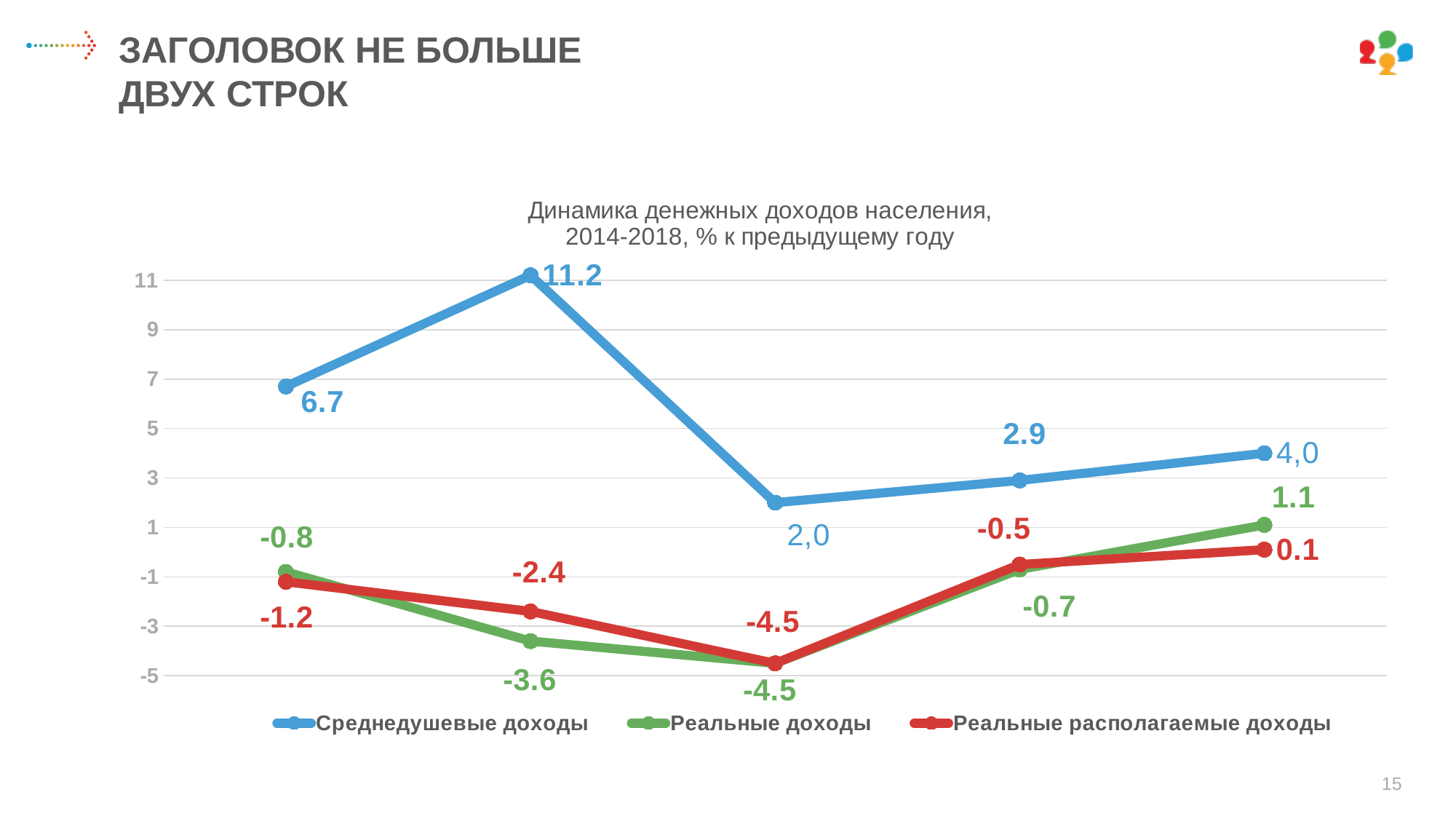
What is the value of the last point of the Реальные располагаемые доходы line? 0.1 What is the difference between the second and first points of the Среднедушевые доходы line? 4.5 What is the value of the last point of the Среднедушевые доходы line? 4,0 At the second point, which series has the larger value: Реальные доходы or Реальные располагаемые доходы? Реальные располагаемые доходы How many series does the legend list? 3 What is the value of the second point of the Среднедушевые доходы line? 11.2 What is the highest value on the Среднедушевые доходы line? 11.2 Does the Реальные доходы line rise or fall from its third point to its fifth point? rise How many data points does each line have? 5 What kind of chart is shown on the slide? line chart What is the value of the fourth point of the Реальные доходы line? -0.7 What is the lowest value on the Реальные доходы line? -4.5